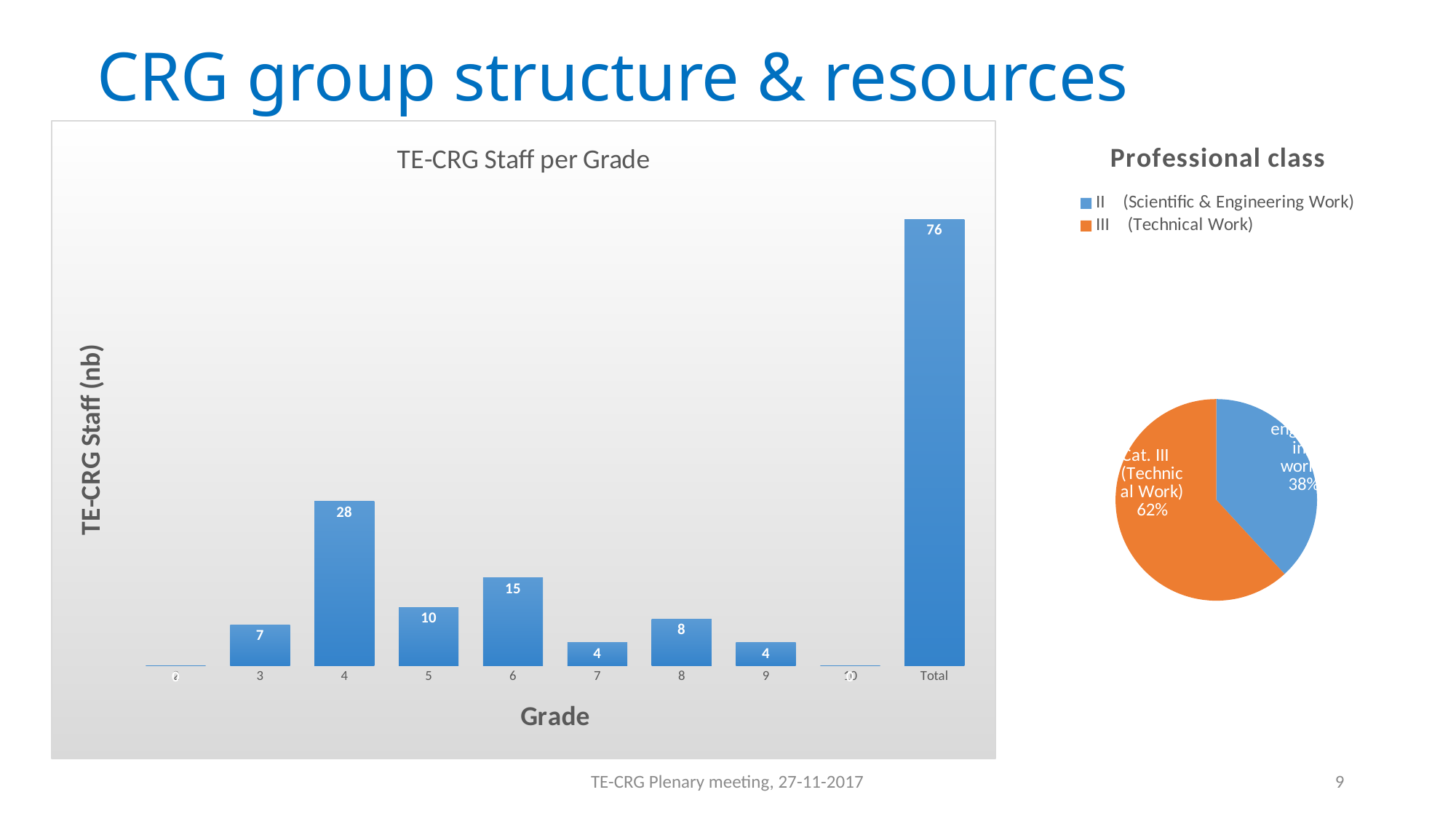
In the 'TE-CRG Staff per Grade' chart, what is the difference between the values for grade 3 and grade 9? 3 In the 'TE-CRG Staff per Grade' chart, excluding the Total bar, which grade has the highest number of staff? 4 In the 'Professional class' pie chart, what share does II (Scientific & Engineering Work) have? 38% In the 'TE-CRG Staff per Grade' chart, what is the value of the Total bar? 76 In the 'TE-CRG Staff per Grade' chart, what is the title of the vertical axis? TE-CRG Staff (nb) In the 'TE-CRG Staff per Grade' chart, what is the difference between the values for grade 4 and grade 6? 13 In the 'Professional class' pie chart, what share does III (Technical Work) have? 62% In the 'TE-CRG Staff per Grade' chart, what is the value for grade 7? 4 In the 'TE-CRG Staff per Grade' chart, what is the value for grade 4? 28 How many entries does the legend of the 'Professional class' pie chart list? 2 In the 'TE-CRG Staff per Grade' chart, which has a larger value, grade 5 or grade 8? grade 5 What kind of chart is 'TE-CRG Staff per Grade'? bar chart